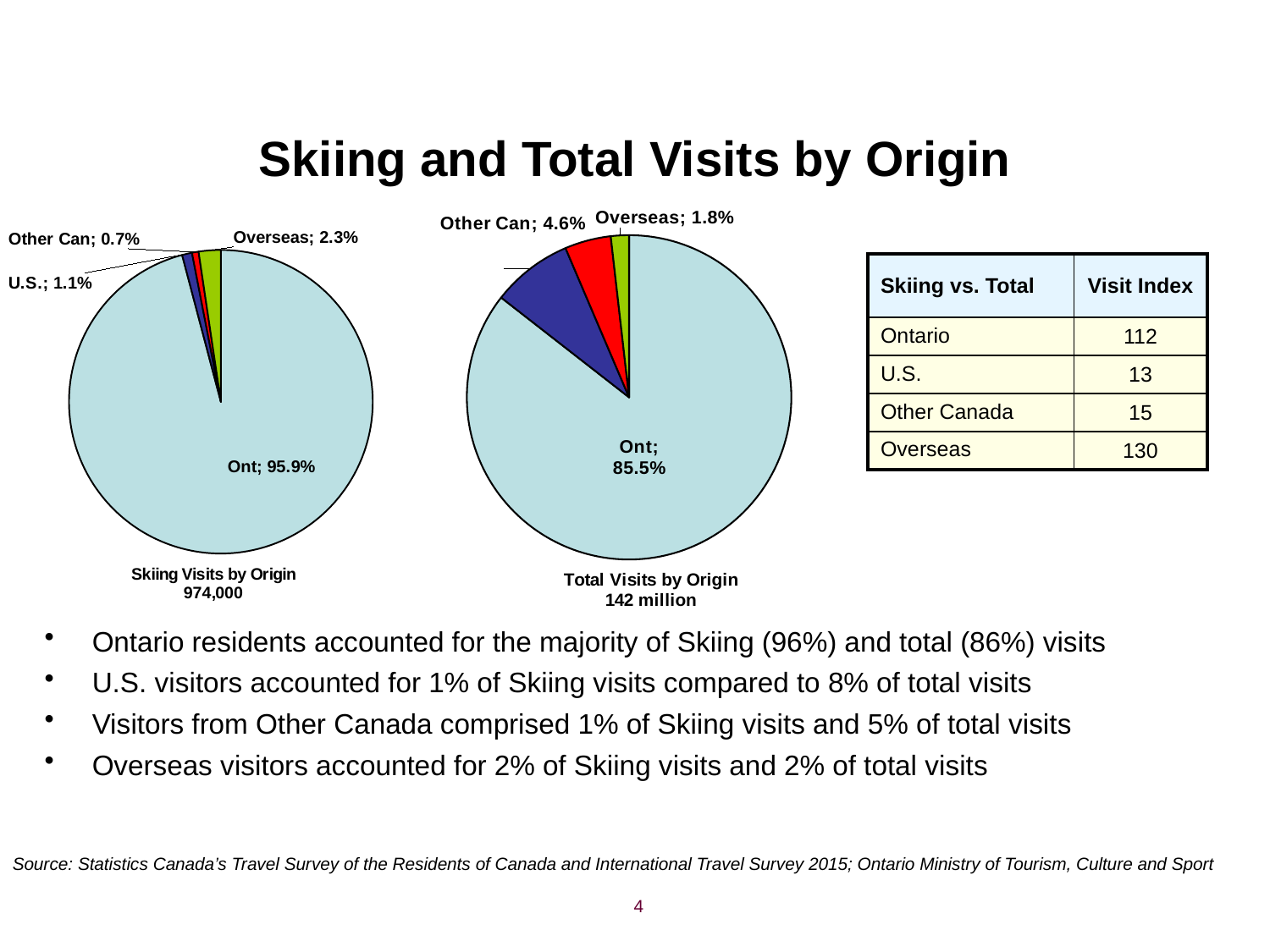
How many slices does the Skiing Visits by Origin pie chart have? 4 In the Skiing Visits by Origin pie chart, which origin has the smallest slice? Other Can Which is larger: the Ontario share in the Skiing Visits by Origin chart or the Ontario share in the Total Visits by Origin chart? Skiing Visits by Origin In the Skiing Visits by Origin pie chart, what share of visits is from Ontario? 95.9% What type of chart is used for Total Visits by Origin? Pie chart In the Skiing Visits by Origin pie chart, what share of visits is from Overseas? 2.3% In the Total Visits by Origin pie chart, what share of visits is from Other Canada? 4.6% In the Skiing Visits by Origin pie chart, what share of visits is from the U.S.? 1.1% What total number of visits is shown under the Skiing Visits by Origin pie chart? 974,000 In the Total Visits by Origin pie chart, what share of visits is from Ontario? 85.5% In the Skiing Visits by Origin pie chart, what is the difference between the Overseas share and the U.S. share? 1.2% In the Total Visits by Origin pie chart, which origin has the largest slice? Ont